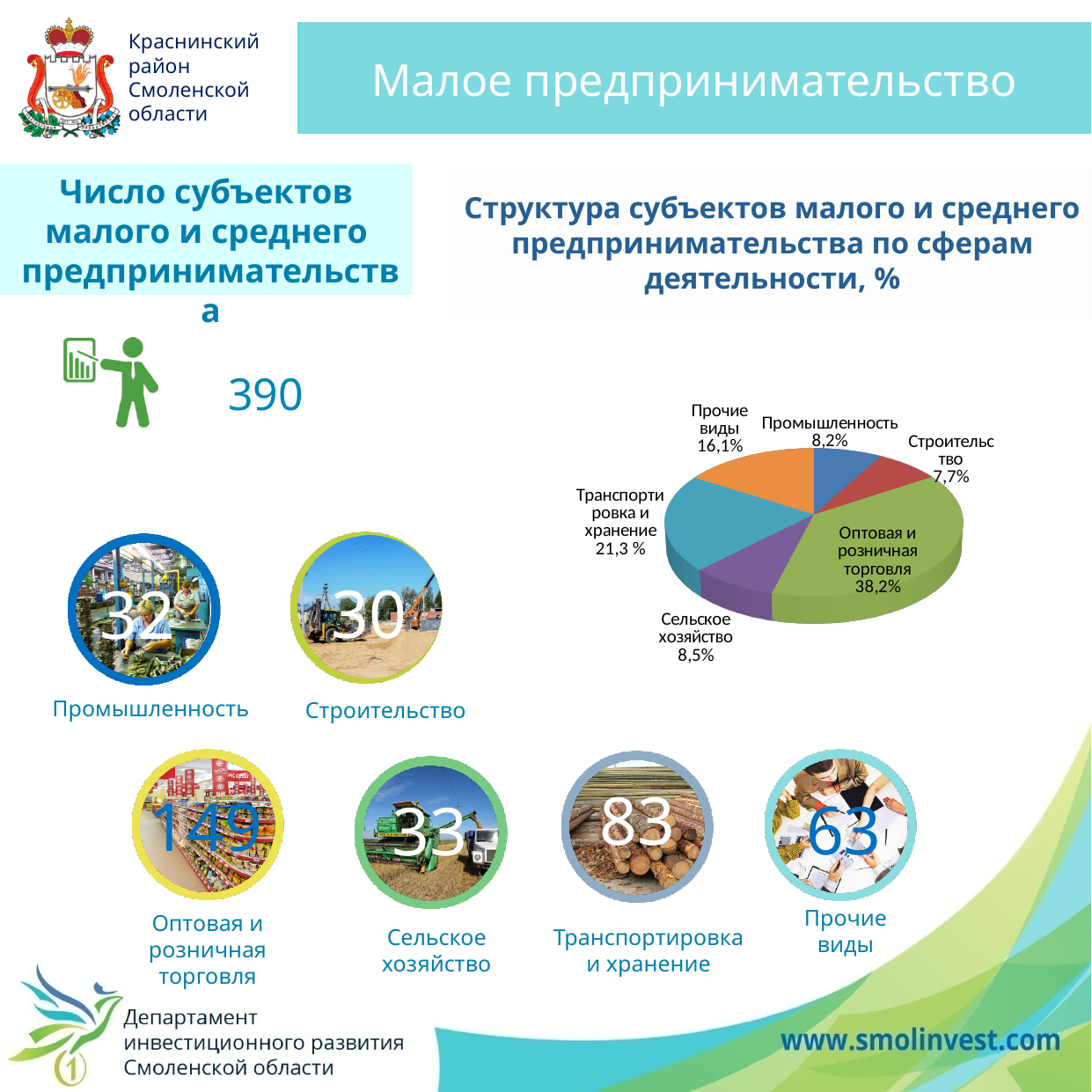
What type of chart is shown on the slide? Pie chart What is the title of the pie chart? Структура субъектов малого и среднего предпринимательства по сферам деятельности, % Which sector has the smallest share in the pie chart? Строительство What is the share of Оптовая и розничная торговля in the pie chart? 38,2% Which sector has the largest share in the pie chart? Оптовая и розничная торговля What is the share of Транспортировка и хранение in the pie chart? 21,3 % What is the share of Сельское хозяйство in the pie chart? 8,5% What is the difference in percentage points between Оптовая и розничная торговля and Транспортировка и хранение in the pie chart? 16,9 Which is larger in the pie chart: Транспортировка и хранение or Прочие виды? Транспортировка и хранение What is the share of Строительство in the pie chart? 7,7% How many slices does the pie chart have? 6 What is the share of Прочие виды in the pie chart? 16,1%